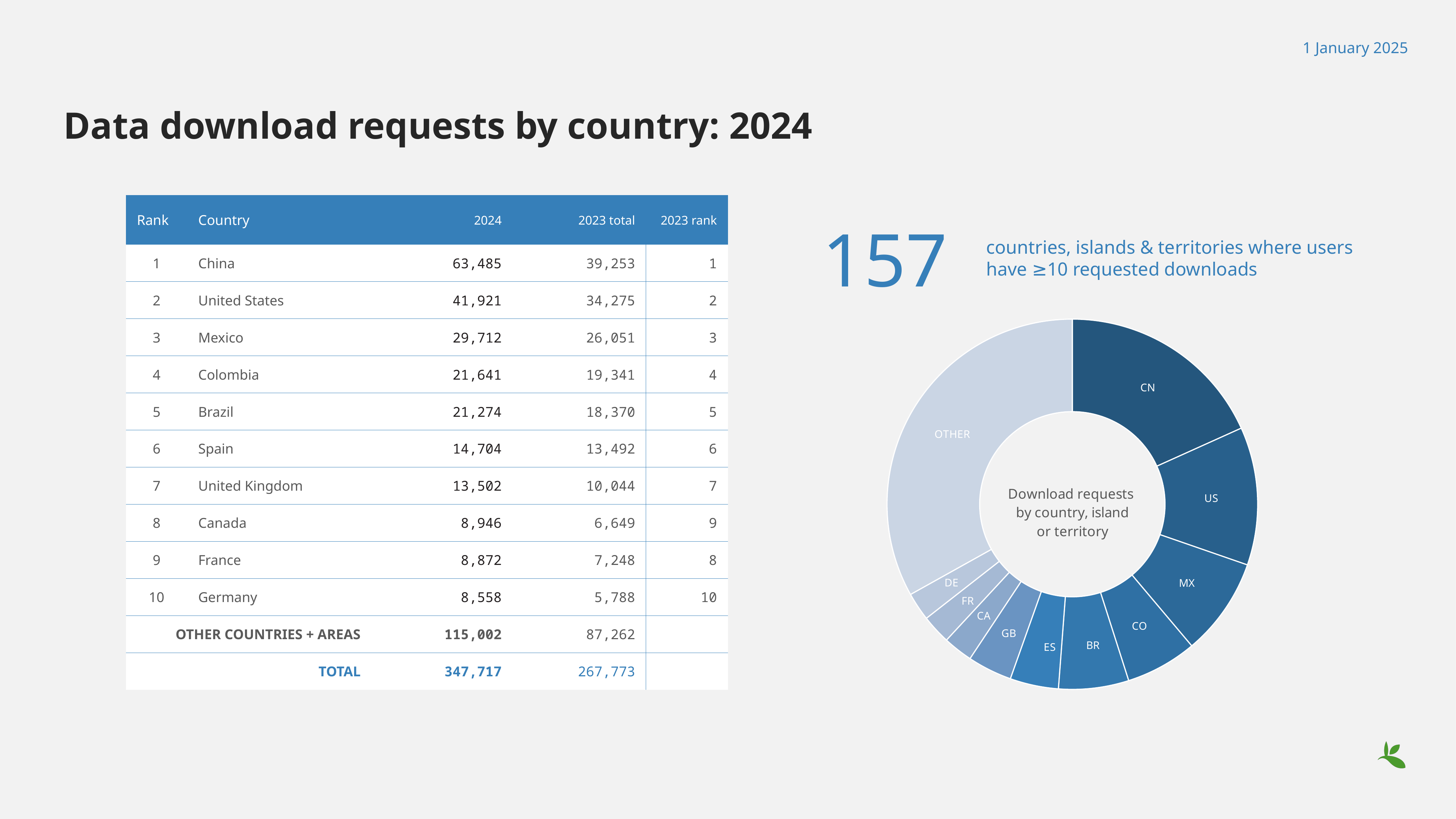
Which single country has the largest slice in the donut chart? CN How many slices does the donut chart have? 11 What is the difference between China's and the United States' 2024 download requests? 21,564 According to the table, how many download requests did Mexico have in 2024? 29,712 In the donut chart, is the US slice larger or smaller than the MX slice? Larger What is the total number of download requests in 2024 shown in the table? 347,717 What kind of chart is shown on the right of the slide? Donut (pie) chart According to the table, how many download requests did China have in 2024? 63,485 What text is written in the centre of the donut chart? Download requests by country, island or territory What is the large number shown above the donut chart? 157 Which slice of the donut chart is the largest? OTHER Which labelled country slice in the donut chart is the smallest? DE